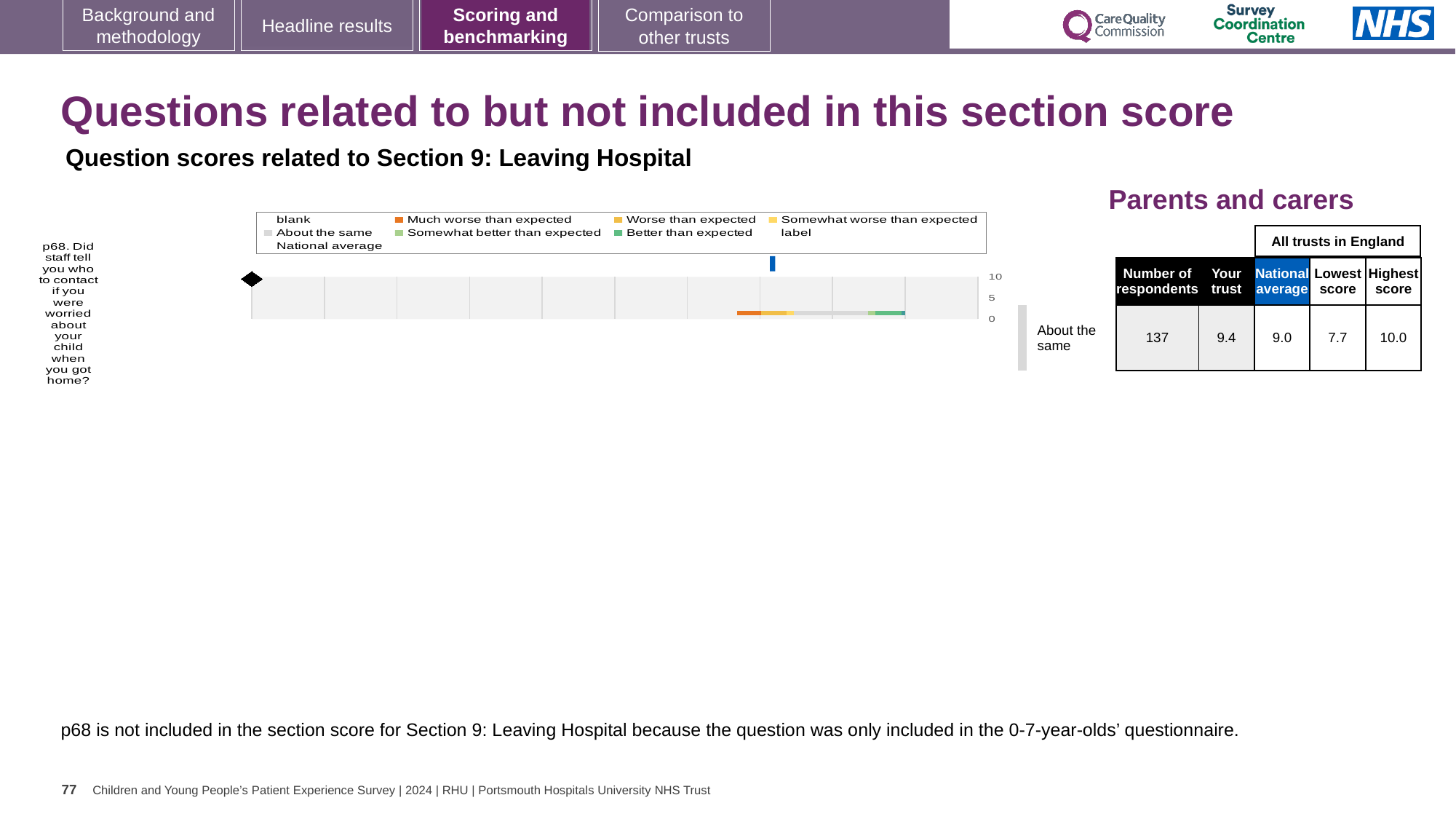
How many respondents answered p68? 137 Which is larger for p68, the 'Your trust' score or the national average? Your trust What is the national average score for p68? 9.0 What is the 'Your trust' score for p68? 9.4 What is the question number of the single item plotted in the chart? p68 What is the lowest score among all trusts in England for p68? 7.7 What is the highest score among all trusts in England for p68? 10.0 What is the highest tick value shown on the chart's axis? 10 What kind of chart is used to show the p68 question score? bar chart How is the trust's result for p68 categorised relative to expectations? About the same How many questions are plotted in the chart? 1 What is the difference between the 'Your trust' score and the national average for p68? 0.4